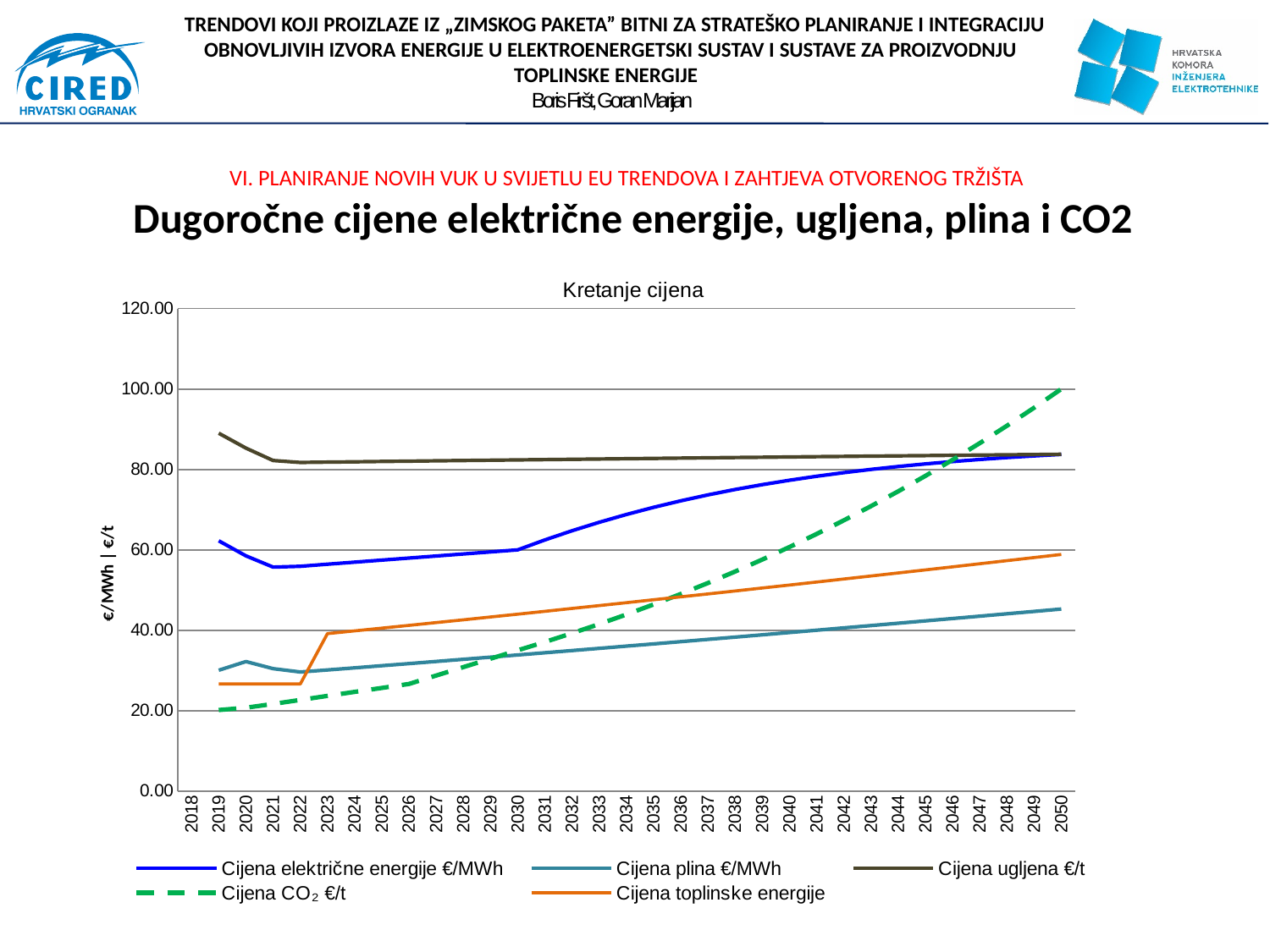
Is the value for Cijena CO₂ €/t in 2030 greater or less than 40? less How many series does the legend of the chart list? 5 Which series has the highest value in 2019? Cijena ugljena €/t Is the value for Cijena ugljena €/t in 2019 greater or less than 80? greater Is the value for Cijena električne energije €/MWh in 2021 greater or less than 60? less In 2040, which is larger: Cijena električne energije €/MWh or Cijena CO₂ €/t? Cijena električne energije €/MWh Which series in the chart is drawn with a dashed line? Cijena CO₂ €/t What kind of chart is shown on the slide? line chart What is the title of the chart? Kretanje cijena Which series has the highest value in 2050? Cijena CO₂ €/t Does the value for Cijena CO₂ €/t rise or fall from 2019 to 2050? rise Which series has the lowest value in 2019? Cijena CO₂ €/t